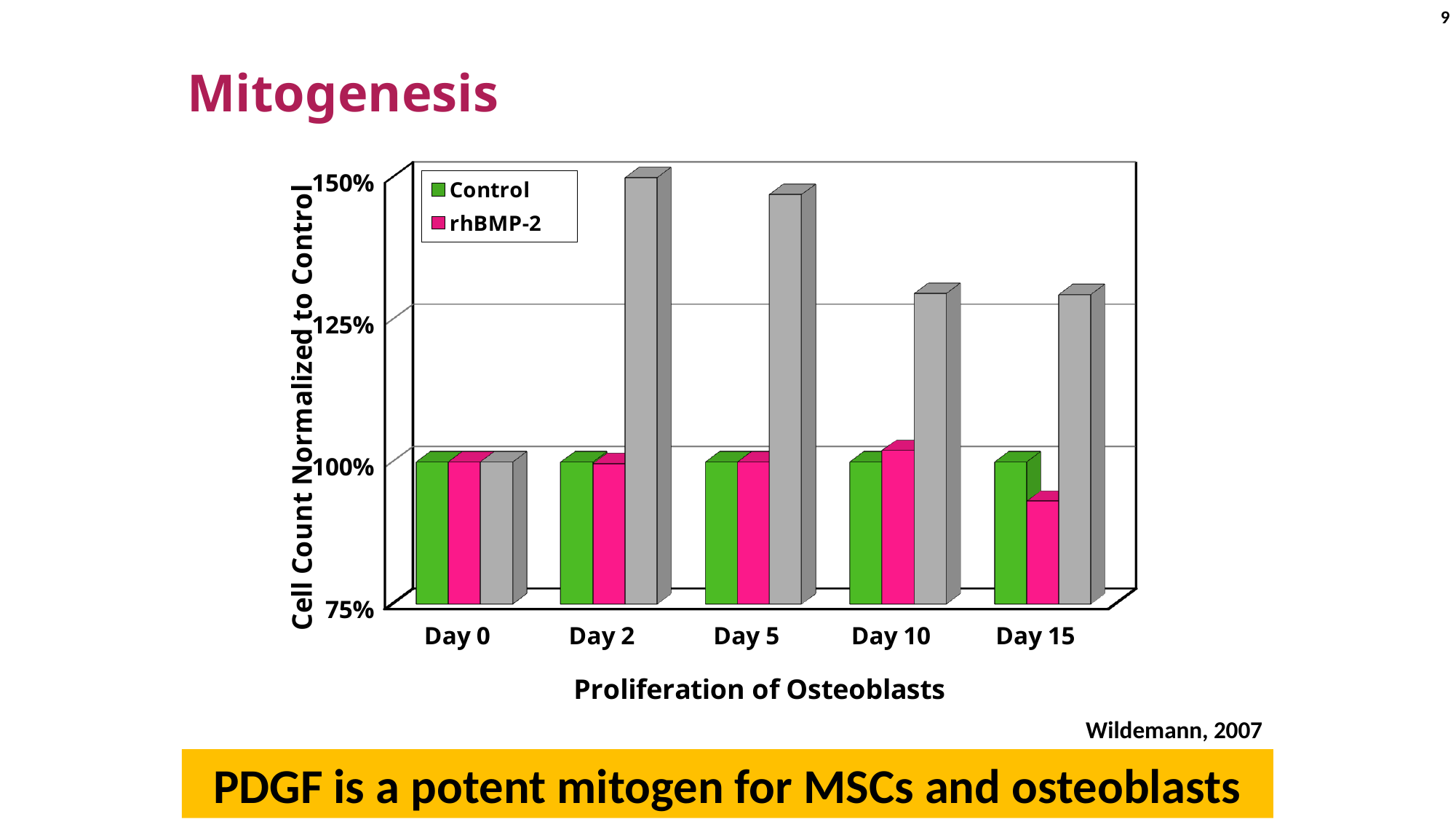
What kind of chart is shown on the slide? bar chart Is the value of the gray bar at Day 15 greater or less than 150%? less How many series does the chart's legend list? 2 Is the value of the gray bar at Day 2 greater or less than 125%? greater Is the value of the gray bar at Day 10 greater or less than 125%? greater What colour does the legend use for the Control series? green At Day 15, which is larger: the Control bar or the rhBMP-2 bar? Control Do the values of the gray bars rise or fall from Day 2 to Day 15? fall What is the label on the y axis of the chart? Cell Count Normalized to Control How many day categories are shown on the x axis of the chart? 5 At Day 2, which is larger: the rhBMP-2 bar or the gray bar? the gray bar